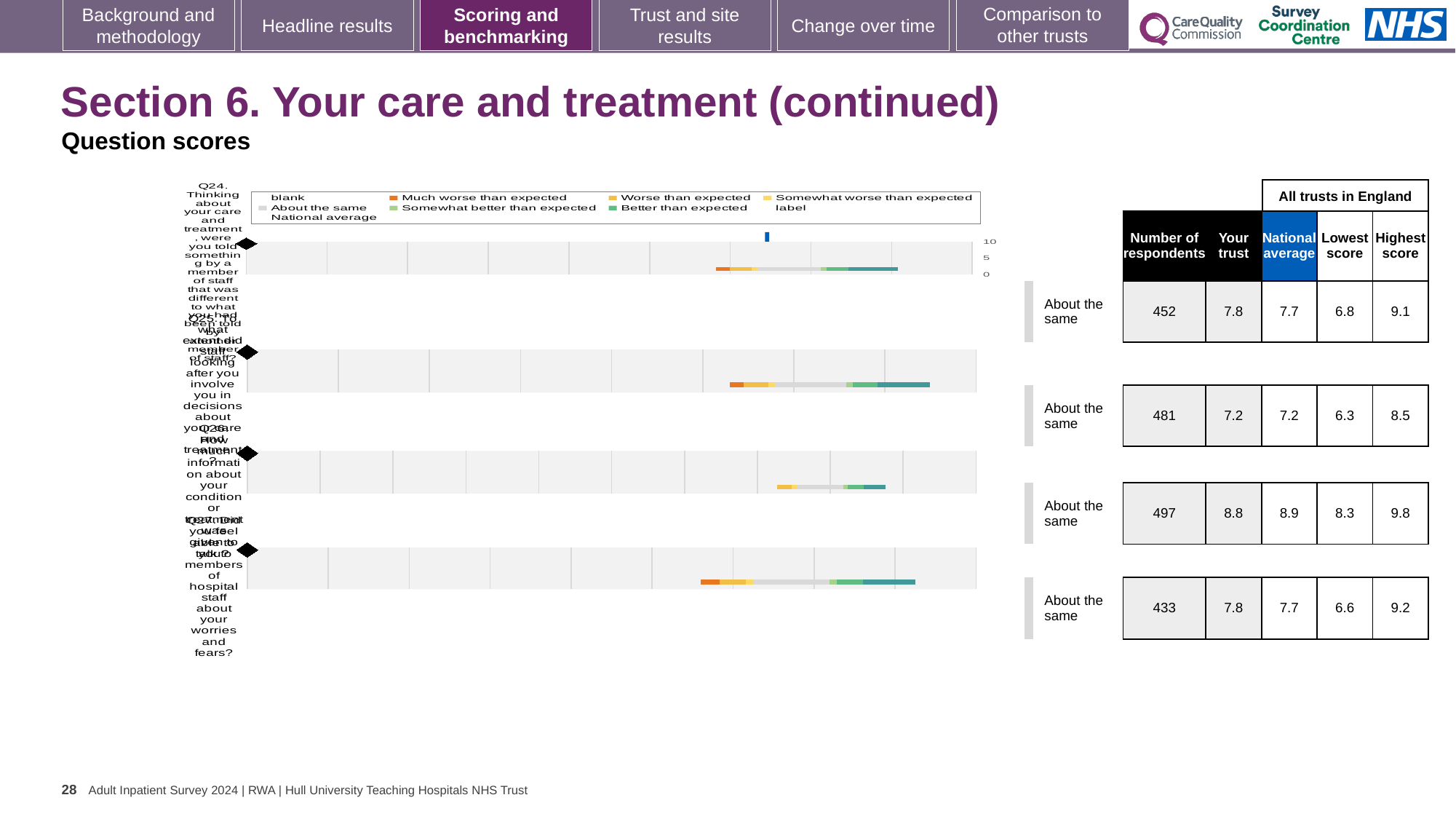
Which question has the highest 'Your trust' score? Q26 What is the highest score among all trusts in England for Q27? 9.2 Which question has the lowest 'Your trust' score? Q25 Which question has the largest number of respondents? Q26 How many questions (Q24 to Q27) are plotted in the chart? 4 What is the difference between the highest score and the lowest score for Q26? 1.5 For Q24, which is larger: the 'Your trust' score or the national average? Your trust What kind of chart is used to show the question scores on this slide? bar chart How many respondents are listed for Q25? 481 According to the table, what is the national average for Q26? 8.9 What benchmark category label is shown next to each of the four questions? About the same According to the table, what is the 'Your trust' score for Q24? 7.8